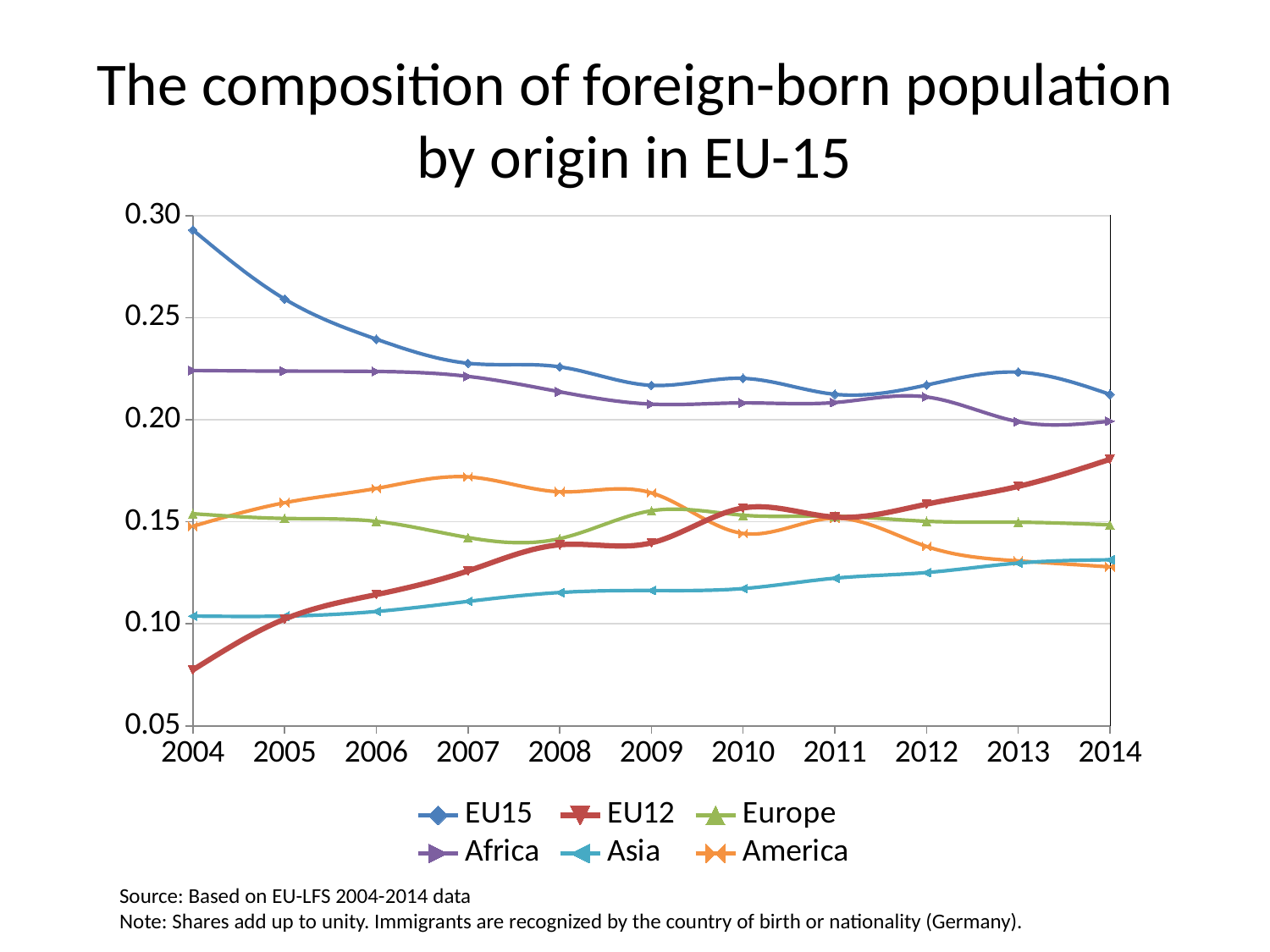
How many series does the legend list? 6 Does the EU15 series rise or fall overall from 2004 to 2014? fall How many years are plotted along the x axis? 11 Is the value for EU12 in 2004 greater or less than 0.10? less In 2014, which is larger, the value for EU12 or the value for Europe? EU12 What is the title of the chart? The composition of foreign-born population by origin in EU-15 Which series has the lowest value in 2004? EU12 Is the value for EU15 in 2004 greater or less than 0.25? greater Does the EU12 series rise or fall overall from 2004 to 2014? rise What kind of chart is shown on the slide? line chart Which series has the highest value in 2004? EU15 Is the value for Asia in 2004 greater or less than 0.15? less